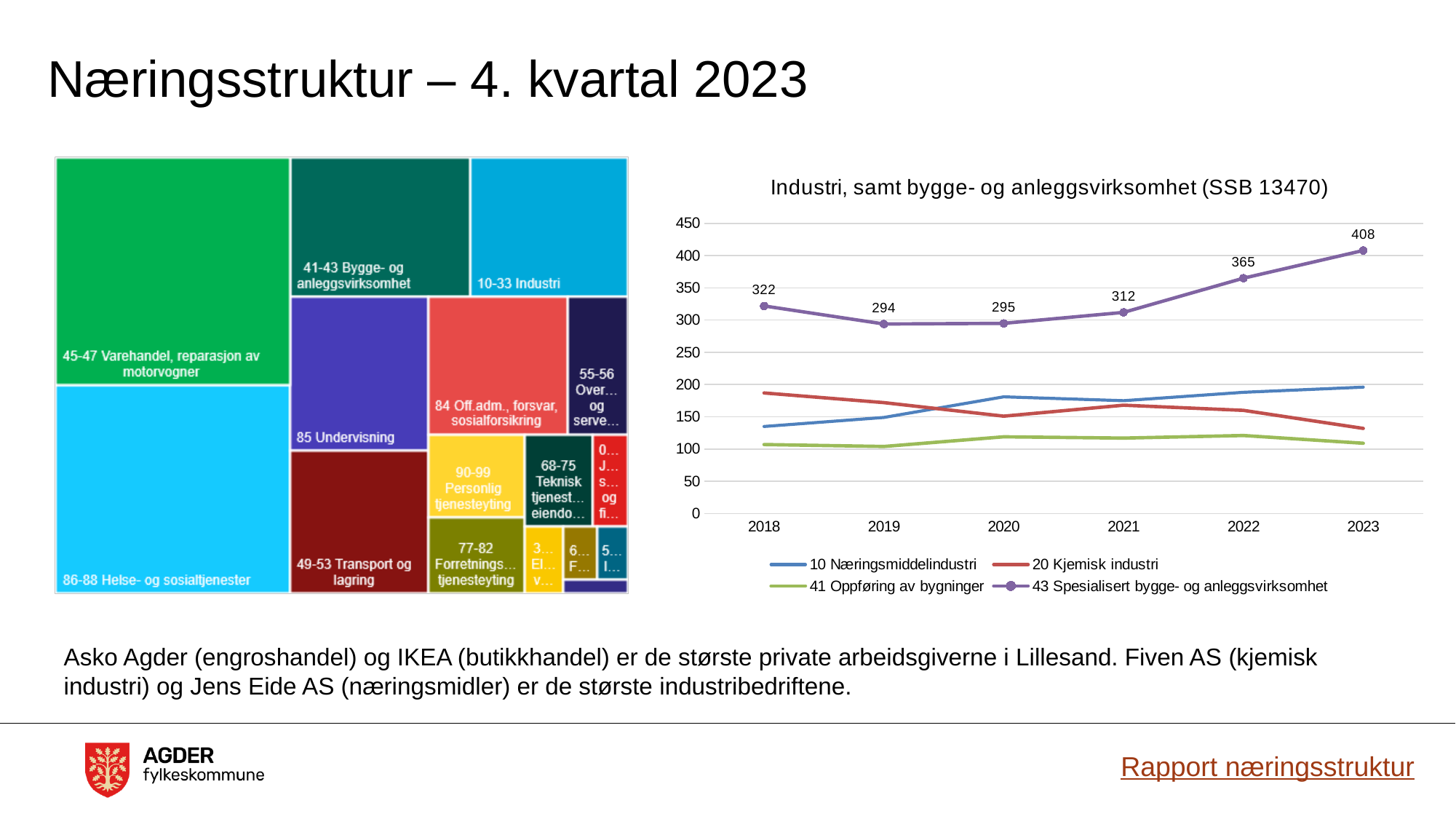
In the line chart 'Industri, samt bygge- og anleggsvirksomhet (SSB 13470)', what is the value for 43 Spesialisert bygge- og anleggsvirksomhet in 2018? 322 How many series does the legend of the line chart on the right list? 4 In the line chart on the right, in which year is 43 Spesialisert bygge- og anleggsvirksomhet lowest? 2019 In the line chart on the right, does 43 Spesialisert bygge- og anleggsvirksomhet rise or fall from 2020 to 2023? Rise In the line chart on the right, is the value for 10 Næringsmiddelindustri in 2023 greater or less than 150? greater In the line chart on the right, by how much did 43 Spesialisert bygge- og anleggsvirksomhet increase from 2022 to 2023? 43 What kind of chart is the chart on the right of the slide? Line chart In the line chart on the right, which is larger in 2018: 20 Kjemisk industri or 10 Næringsmiddelindustri? 20 Kjemisk industri In the line chart 'Industri, samt bygge- og anleggsvirksomhet (SSB 13470)', what is the value for 43 Spesialisert bygge- og anleggsvirksomhet in 2023? 408 In the line chart on the right, what is the difference between the 2018 and 2019 values for 43 Spesialisert bygge- og anleggsvirksomhet? 28 In the line chart on the right, in which year is 43 Spesialisert bygge- og anleggsvirksomhet highest? 2023 How many years are shown on the x axis of the line chart on the right? 6